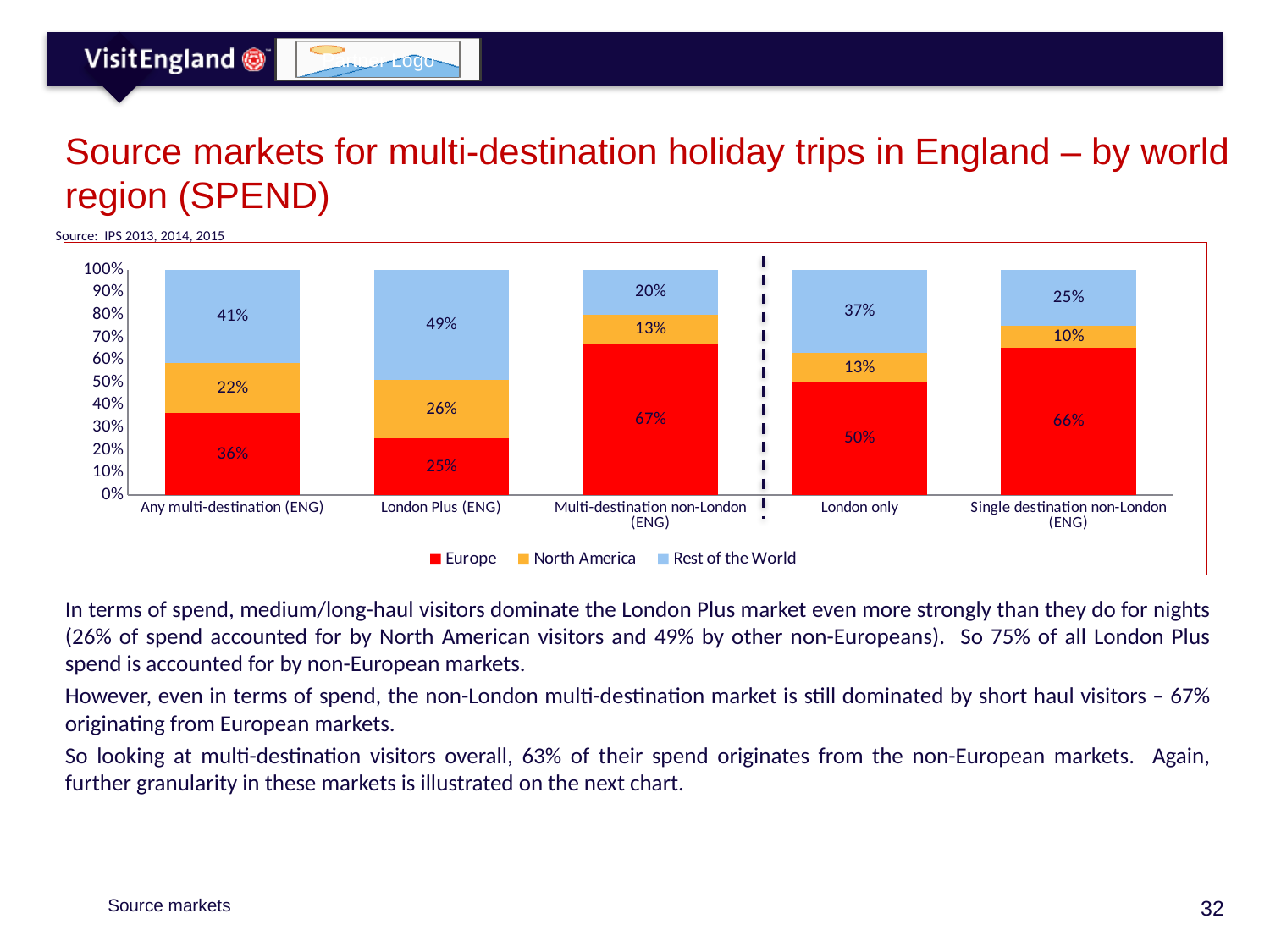
Which is larger: the North America share for London Plus (ENG) or for London only? London Plus (ENG) What is the North America share for Single destination non-London (ENG)? 10% Which category has the lowest Rest of the World share? Multi-destination non-London (ENG) Which colour represents Europe in the chart? Red What type of chart is shown on the slide? Stacked bar chart What share of spend for London Plus (ENG) comes from Europe? 25% What is the difference between the Rest of the World share for London Plus (ENG) and for Multi-destination non-London (ENG)? 29% How many series does the legend list? 3 How many categories are shown on the x axis? 5 What is the Europe share for London only? 50% What is the Rest of the World share for Any multi-destination (ENG)? 41% Which category has the highest Europe share? Multi-destination non-London (ENG)